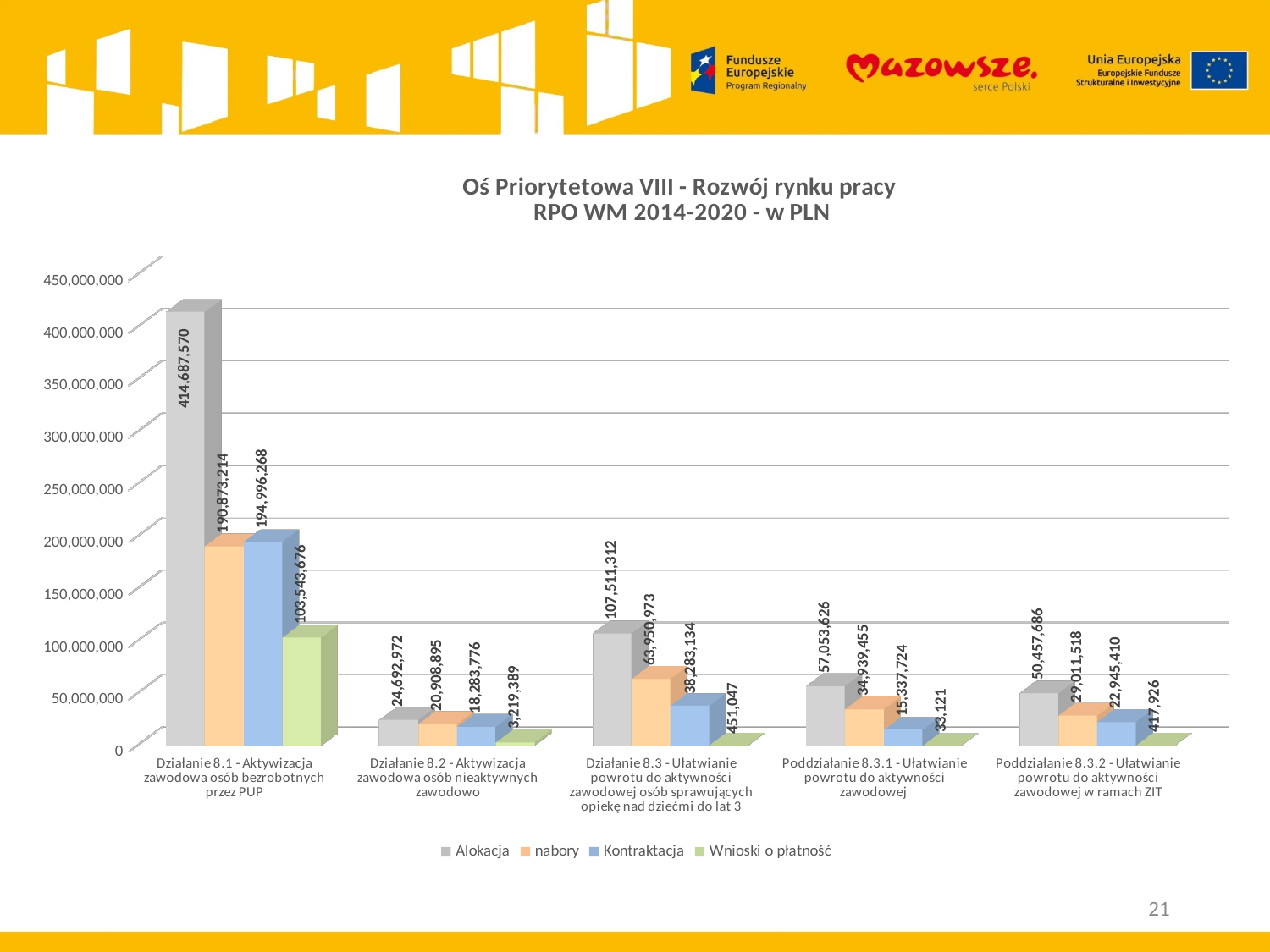
What is the Kontraktacja value for Poddziałanie 8.3.2 - Ułatwianie powrotu do aktywności zawodowej w ramach ZIT? 22,945,410 What is the difference between the Alokacja values for Działanie 8.3 and Poddziałanie 8.3.1? 50,457,686 How many series does the legend list? 4 Which category has the lowest Wnioski o płatność value? Poddziałanie 8.3.1 - Ułatwianie powrotu do aktywności zawodowej What is the Alokacja value for Działanie 8.1 - Aktywizacja zawodowa osób bezrobotnych przez PUP? 414,687,570 What kind of chart is shown on the slide? bar chart What is the nabory value for Działanie 8.2 - Aktywizacja zawodowa osób nieaktywnych zawodowo? 20,908,895 What is the Wnioski o płatność value for Działanie 8.3 - Ułatwianie powrotu do aktywności zawodowej osób sprawujących opiekę nad dziećmi do lat 3? 451,047 Which category has the highest Alokacja value? Działanie 8.1 - Aktywizacja zawodowa osób bezrobotnych przez PUP How many categories are shown on the x axis? 5 Which is larger: the Alokacja for Poddziałanie 8.3.1 or for Poddziałanie 8.3.2? Poddziałanie 8.3.1 Is the Alokacja value for Działanie 8.1 greater or less than 400,000,000? greater